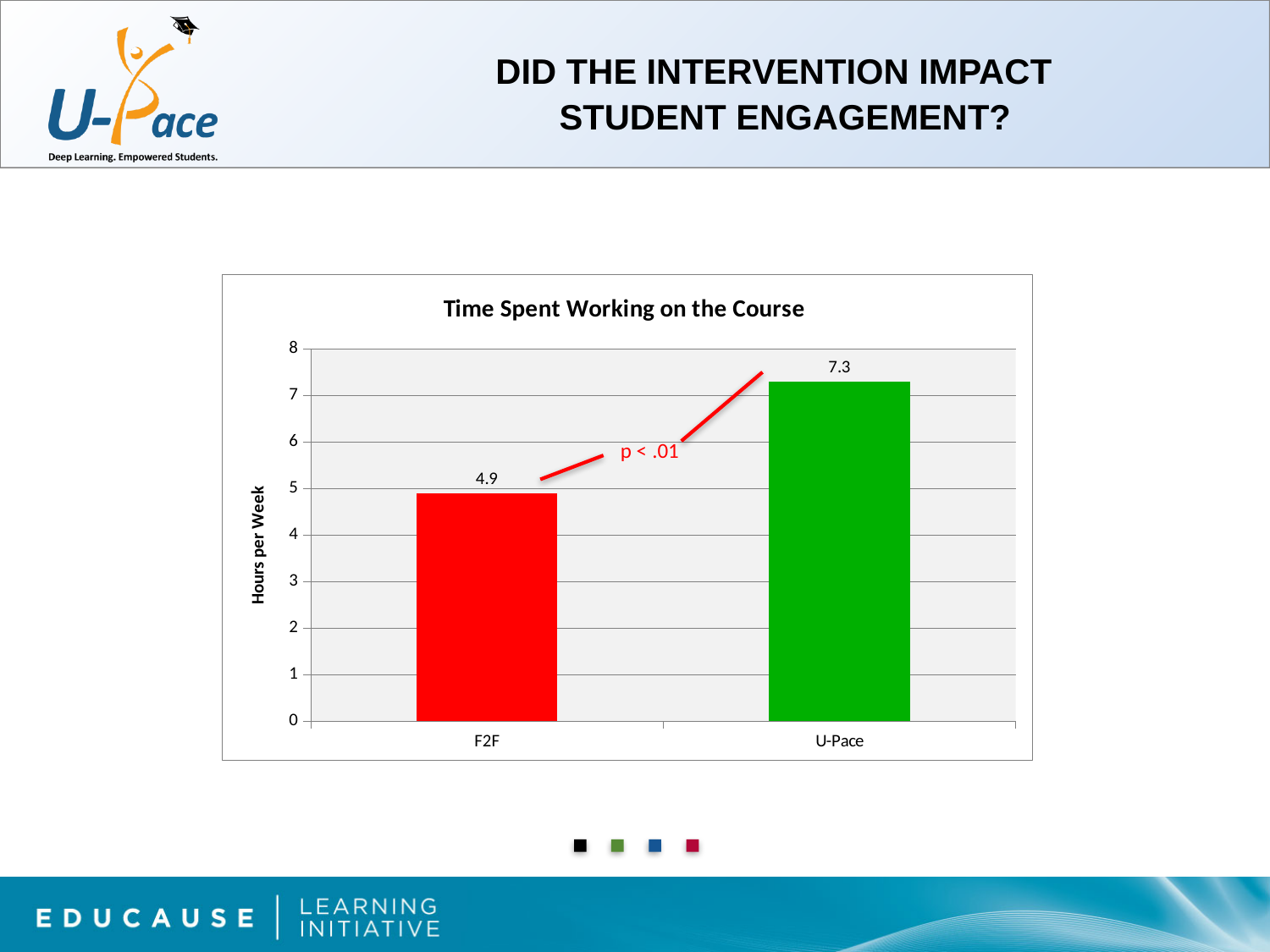
Which category has the highest value in the chart? U-Pace Which category has the lowest value in the chart? F2F Is the value for F2F greater or less than 5? less What is the title of the chart? Time Spent Working on the Course What is the value for F2F in the Time Spent Working on the Course chart? 4.9 What kind of chart is shown on the slide? bar chart How many categories are shown on the x axis of the chart? 2 What is the value for U-Pace in the Time Spent Working on the Course chart? 7.3 Which is larger, the value for F2F or the value for U-Pace? U-Pace What is the difference between the U-Pace and F2F values? 2.4 Is the value for U-Pace greater or less than 7? greater What is the label on the vertical axis of the chart? Hours per Week